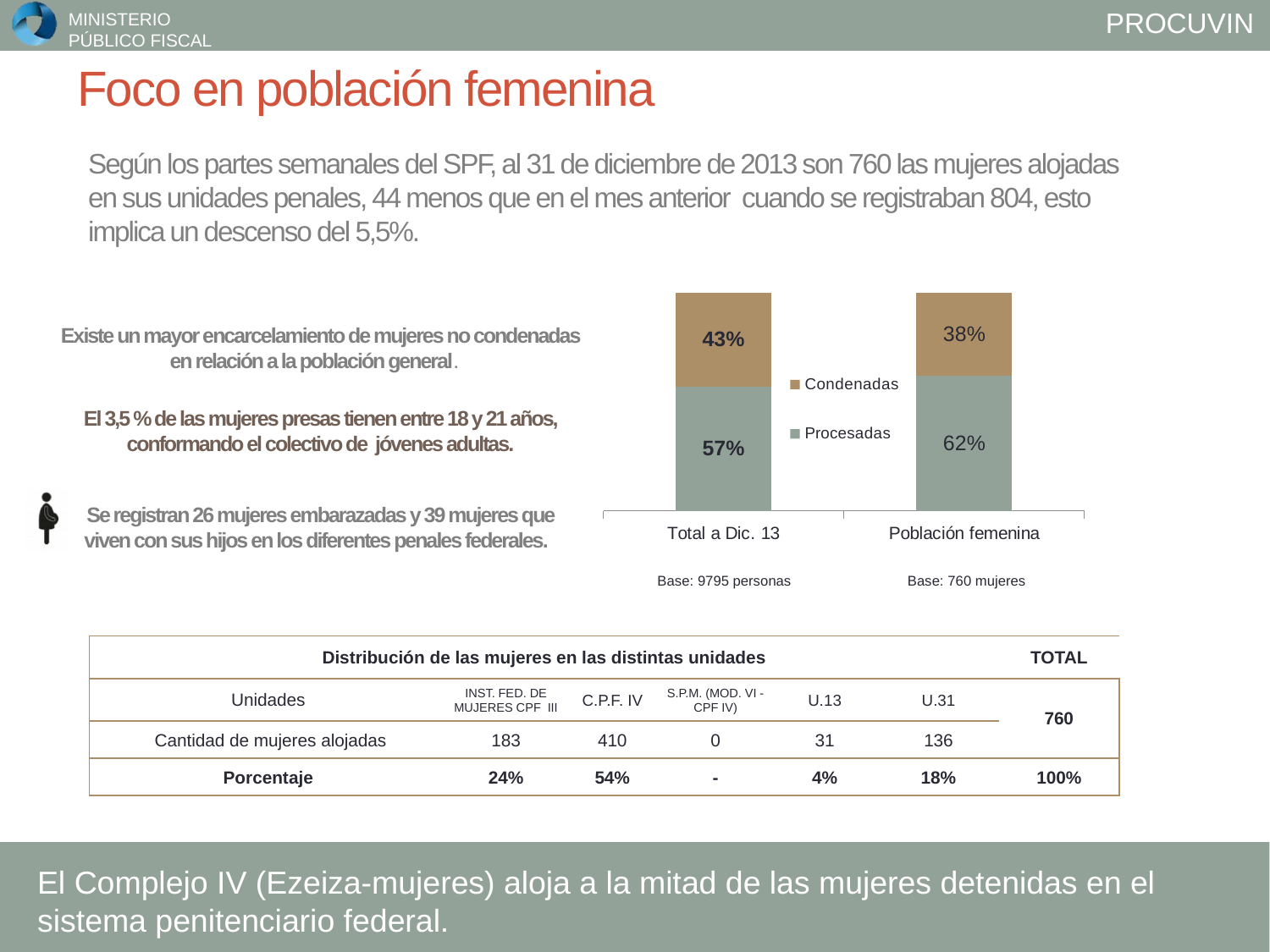
What is the value for Condenadas in the Población femenina bar? 38% How many series does the chart legend list? 2 What is the value for Condenadas in the Total a Dic. 13 bar? 43% What are the two series named in the chart legend? Condenadas and Procesadas What is the difference between the Procesadas values for Población femenina and Total a Dic. 13? 5% What kind of chart is shown on the slide? Stacked bar chart What is the value for Procesadas in the Total a Dic. 13 bar? 57% Which category has the lower Condenadas value? Población femenina How many categories are shown on the x axis of the chart? 2 What is the difference between the Condenadas values for Total a Dic. 13 and Población femenina? 5% Which category has the higher Procesadas value, Total a Dic. 13 or Población femenina? Población femenina What is the value for Procesadas in the Población femenina bar? 62%